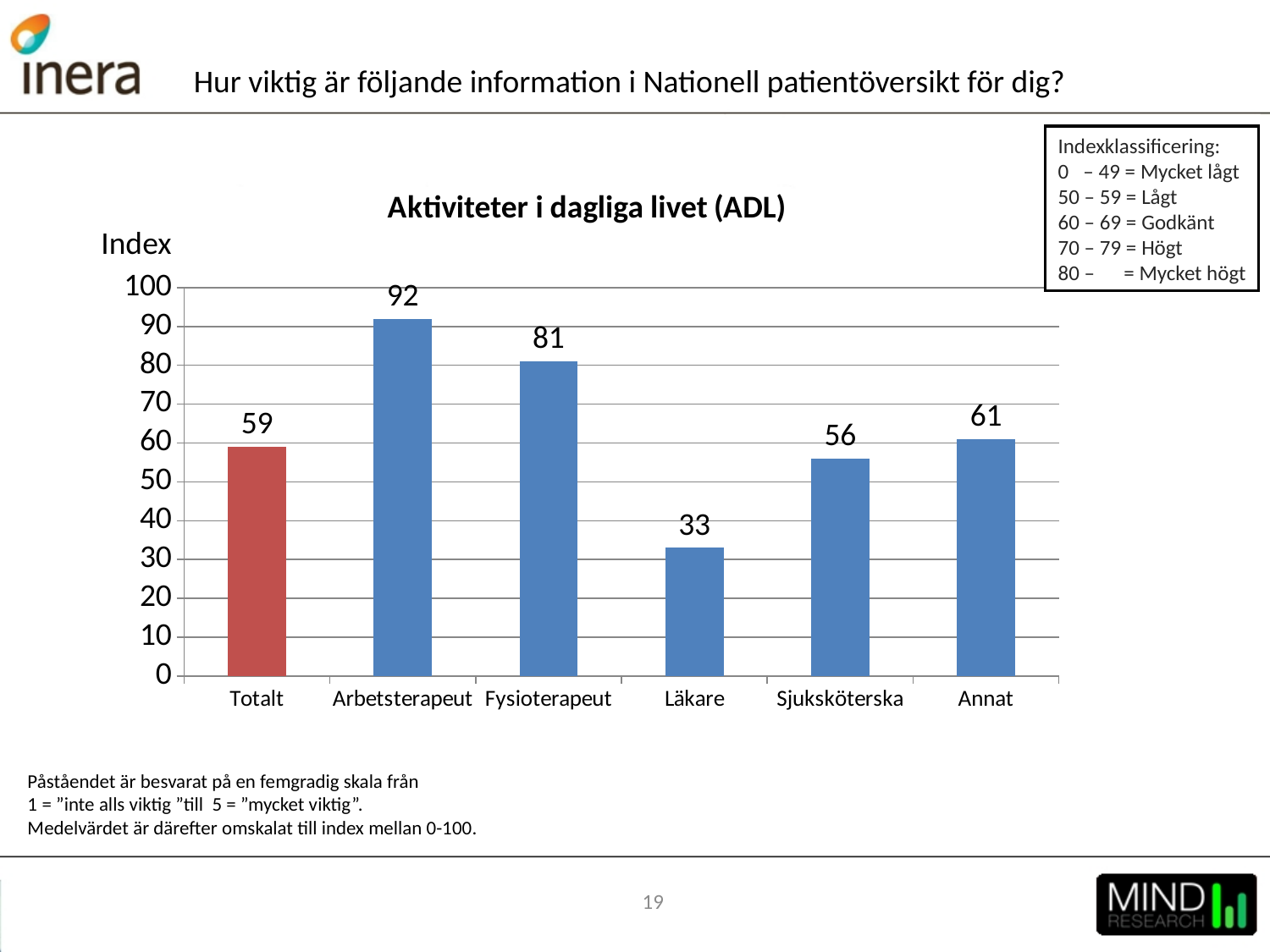
What is the difference between the index values for Arbetsterapeut and Fysioterapeut? 11 Which category has the lowest index value? Läkare What is the index value for Läkare? 33 What is the index value for Arbetsterapeut? 92 What kind of chart is shown on the slide? bar chart How many categories are shown on the x axis? 6 Is the value for Fysioterapeut greater or less than 70? greater Which category has the highest index value? Arbetsterapeut Which bar is coloured differently (red) from the others? Totalt What is the index value for Totalt? 59 Which has a higher index value, Sjuksköterska or Annat? Annat What is the title of the chart? Aktiviteter i dagliga livet (ADL)